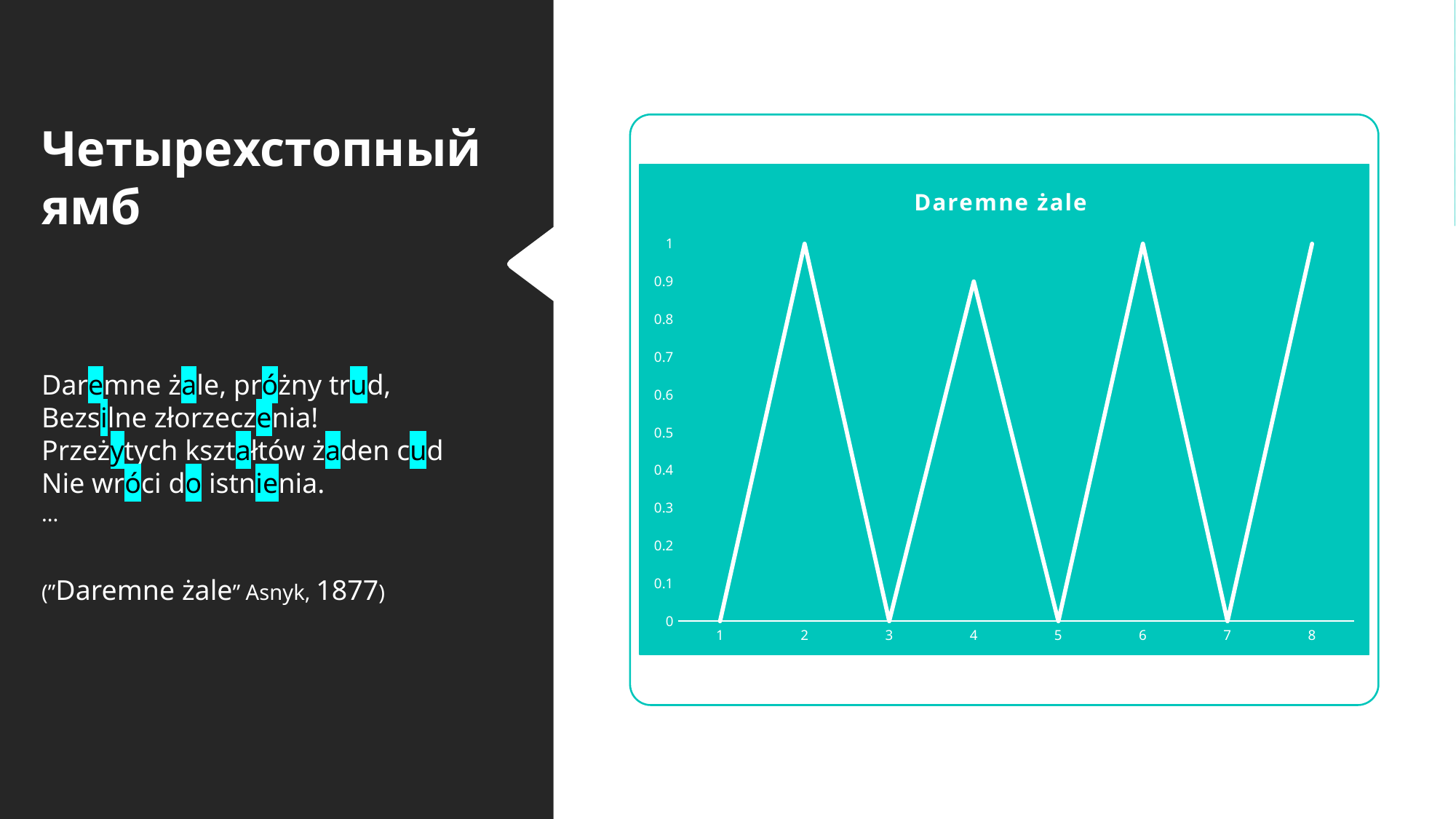
What is the value at x = 2 on the chart? 1 What is the value at x = 4 on the chart? 0.9 How many points are plotted along the x axis of the chart? 8 What is the title of the chart? Daremne żale What is the value at x = 1 on the chart? 0 What kind of chart is shown on the slide? line chart Which is larger, the value at x = 2 or the value at x = 4? x = 2 What is the value at x = 3 on the chart? 0 What is the value at x = 8 on the chart? 1 Is the value at x = 6 greater or less than 0.5? greater What is the difference between the value at x = 2 and the value at x = 4? 0.1 Is the value at x = 7 greater or less than 0.5? less